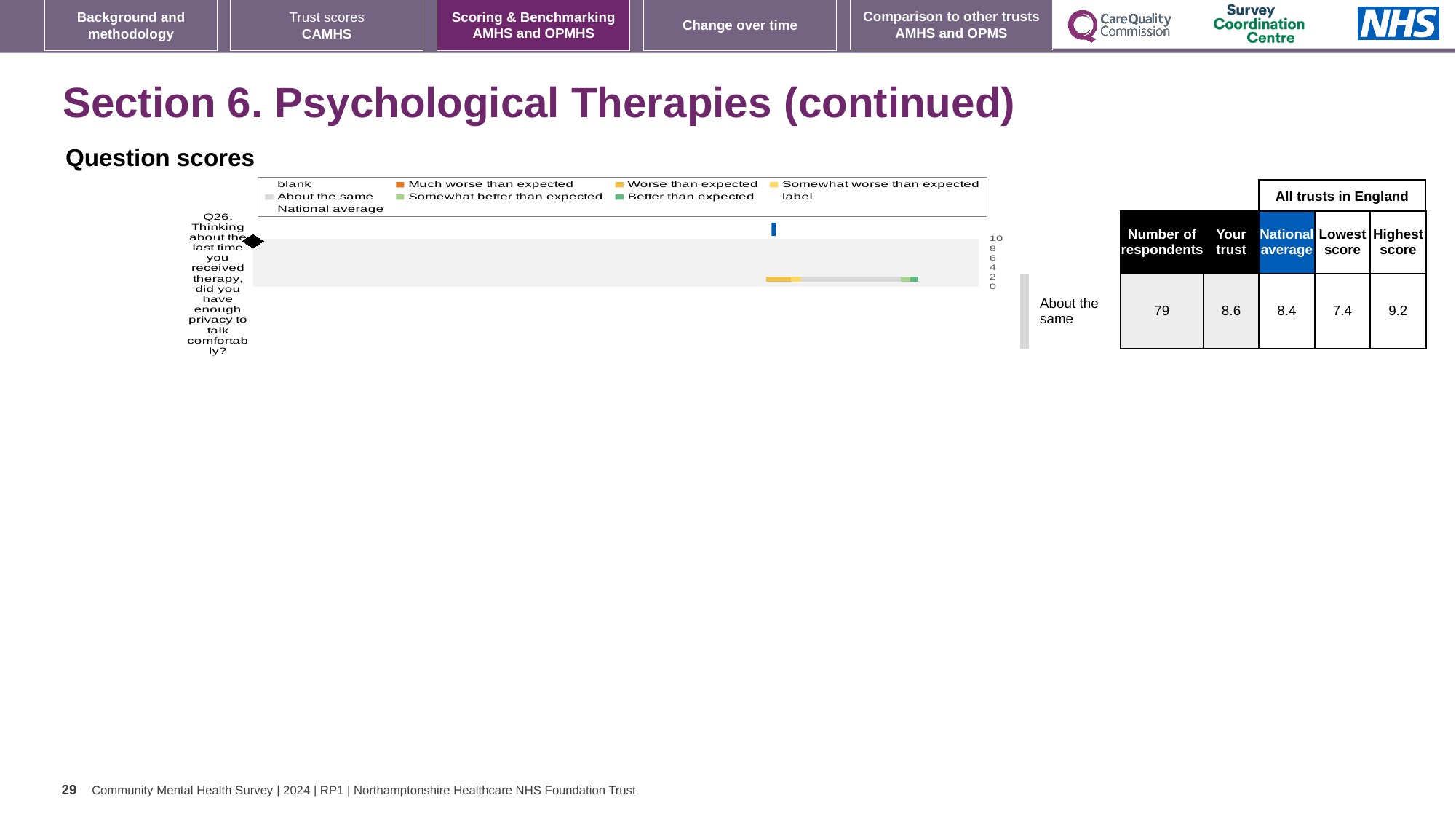
According to the table beside the chart, what is the highest score among all trusts in England for Q26? 9.2 Which question is plotted on the chart? Q26. Thinking about the last time you received therapy, did you have enough privacy to talk comfortably? What benchmark category is shown next to the chart for Q26? About the same What is the highest value shown on the chart's axis? 10 According to the table beside the chart, what is the lowest score among all trusts in England for Q26? 7.4 How many question categories are plotted on the chart? 1 What is the difference between the highest score and the lowest score for Q26 in the table? 1.8 Which is larger for Q26, the 'Your trust' score or the national average? Your trust According to the table beside the chart, what is the national average score for Q26? 8.4 According to the table beside the chart, what is the 'Your trust' score for Q26? 8.6 According to the table beside the chart, what is the number of respondents for Q26? 79 What kind of chart is shown on the slide? Bar chart